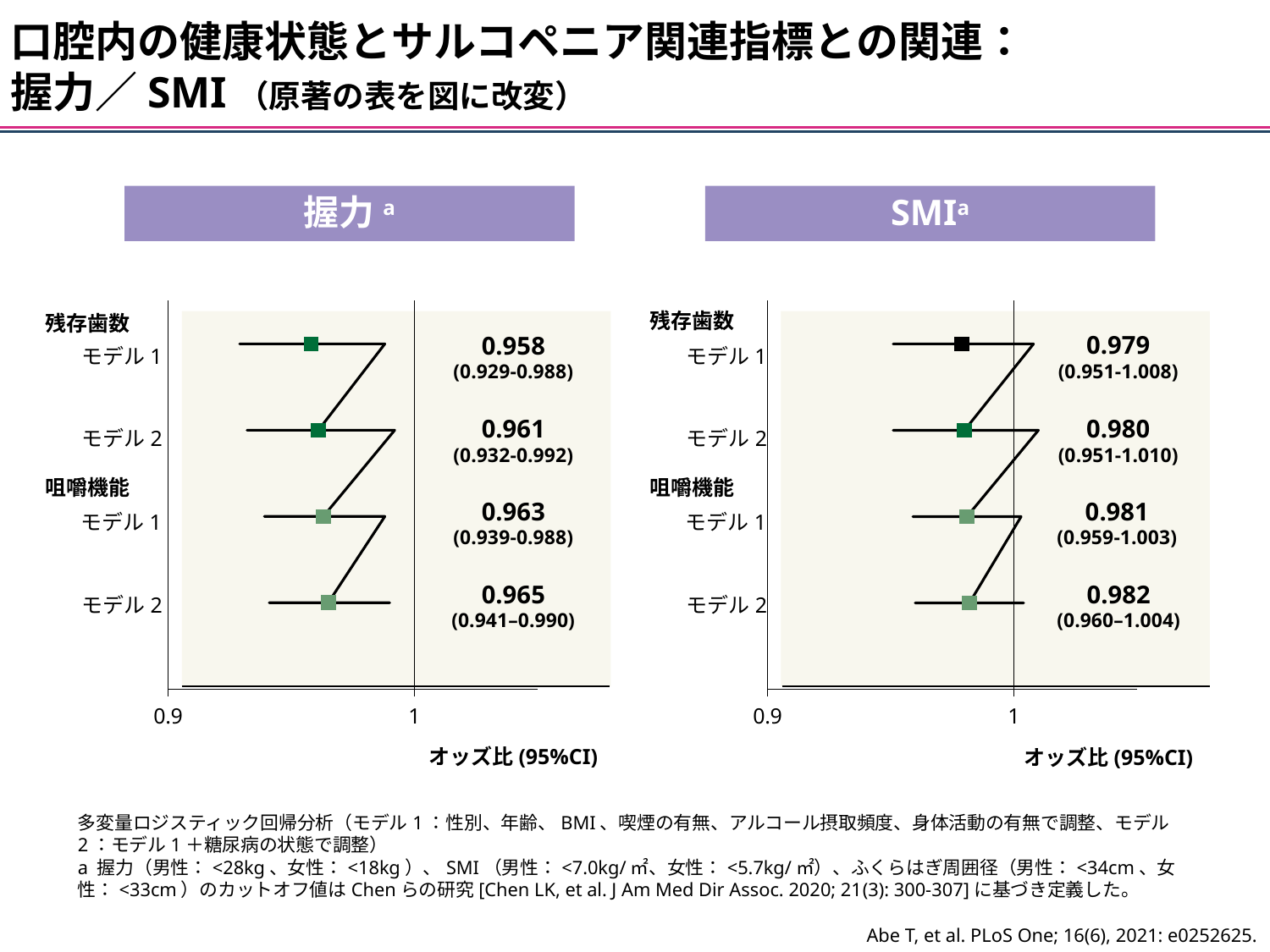
SMIのグラフで、オッズ比が最も高いのはどの項目・モデルですか？ 咀嚼機能 モデル2 握力のグラフで、オッズ比が最も低いのはどの項目・モデルですか？ 残存歯数 モデル1 握力のグラフで、残存歯数のモデル1のオッズ比はいくつですか？ 0.958 SMIのグラフで、咀嚼機能のモデル1のオッズ比の95%信頼区間はいくつですか？ 0.959-1.003 両グラフの横軸のラベルは何ですか？ オッズ比 (95%CI) 握力のグラフで、咀嚼機能のモデル2と残存歯数のモデル1のオッズ比の差はいくつですか？ 0.007 SMIのグラフで、咀嚼機能のモデル2のオッズ比は1より大きいですか、小さいですか？ 小さい 残存歯数のモデル1のオッズ比は、握力のグラフとSMIのグラフのどちらが大きいですか？ SMI 握力のグラフで、上から下へ（残存歯数モデル1から咀嚼機能モデル2へ）オッズ比は増加していますか、減少していますか？ 増加 握力のグラフには、オッズ比の点がいくつプロットされていますか？ 4 握力のグラフで、咀嚼機能のモデル2のオッズ比の95%信頼区間はいくつですか？ 0.941–0.990 SMIのグラフで、残存歯数のモデル2のオッズ比はいくつですか？ 0.980